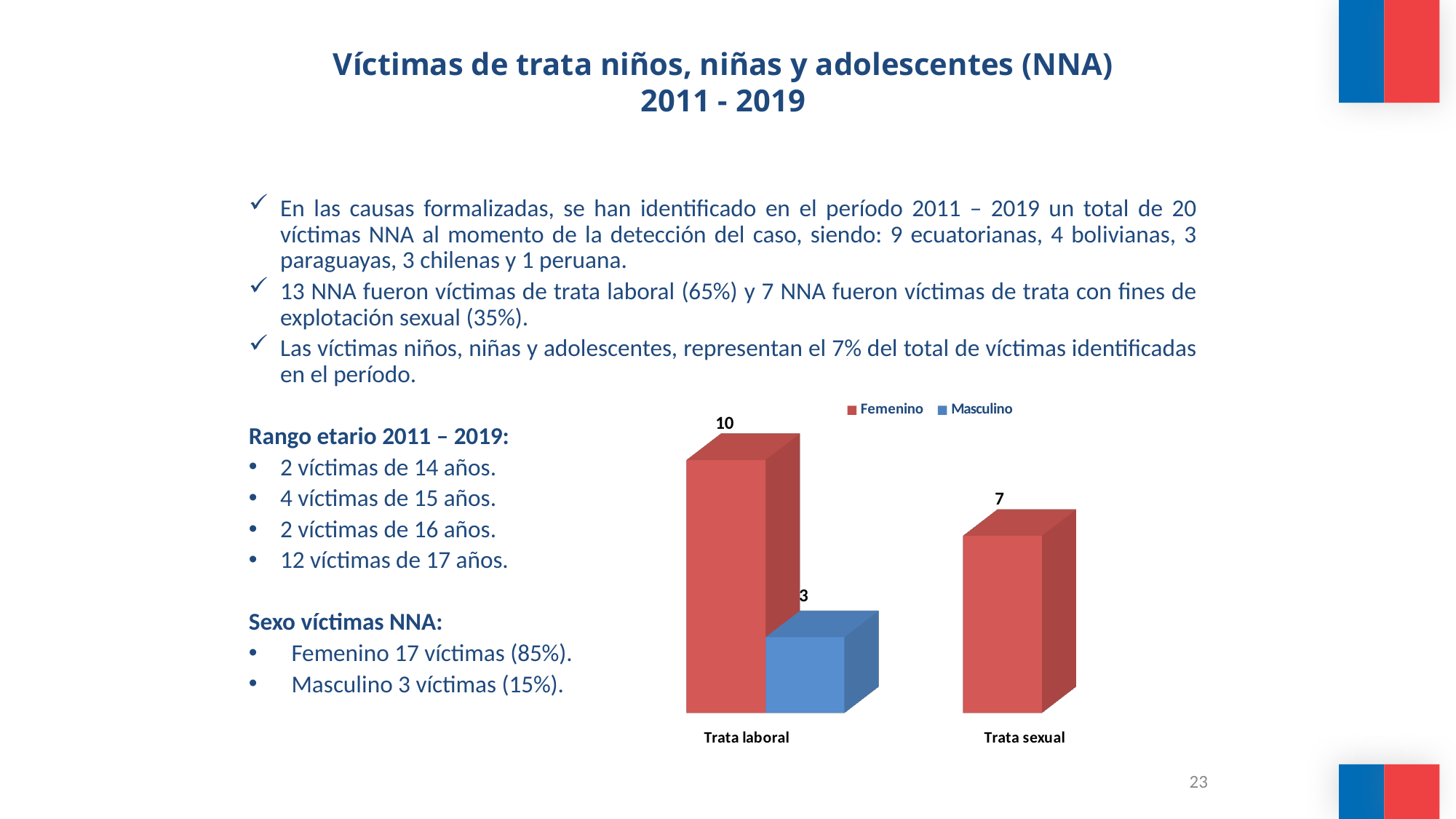
How many categories are shown on the x axis of the chart? 2 What is the Femenino value for Trata laboral? 10 What is the Masculino value for Trata laboral? 3 Which series is shown in red in the chart? Femenino What is the Femenino value for Trata sexual? 7 Which is larger for Trata laboral, the Femenino value or the Masculino value? Femenino Which category has the highest Femenino value? Trata laboral Which category has the lowest Femenino value? Trata sexual How many series does the chart legend list? 2 What is the difference between the Femenino values for Trata laboral and Trata sexual? 3 What kind of chart is shown on the slide? Bar chart What is the difference between the Femenino and Masculino values for Trata laboral? 7